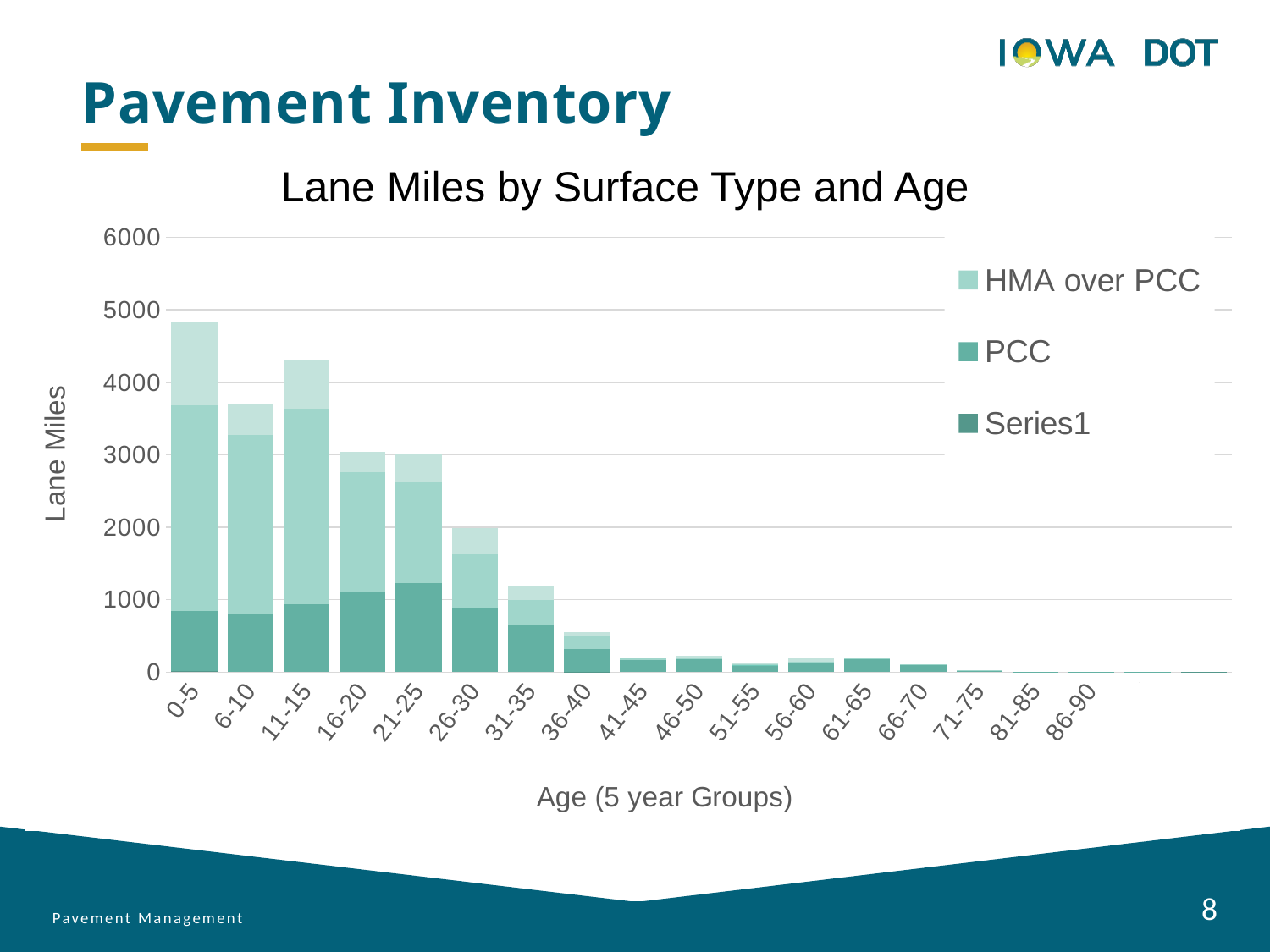
Which has a larger total of lane miles, the 11-15 age group or the 16-20 age group? 11-15 How many age-group categories are shown on the x axis? 17 Is the total lane miles for the 0-5 age group greater or less than 4000? greater Do total lane miles generally rise or fall as age increases along the x axis? fall Is the total lane miles for the 36-40 age group greater or less than 1000? less Is the total lane miles for the 6-10 age group greater or less than 4000? less What is the title of the chart? Lane Miles by Surface Type and Age What kind of chart is shown on the slide? Stacked bar chart What is the label of the x axis? Age (5 year Groups) How many series does the chart's legend list? 3 Which age group has the highest total lane miles? 0-5 Which has a larger total of lane miles, the 26-30 age group or the 31-35 age group? 26-30